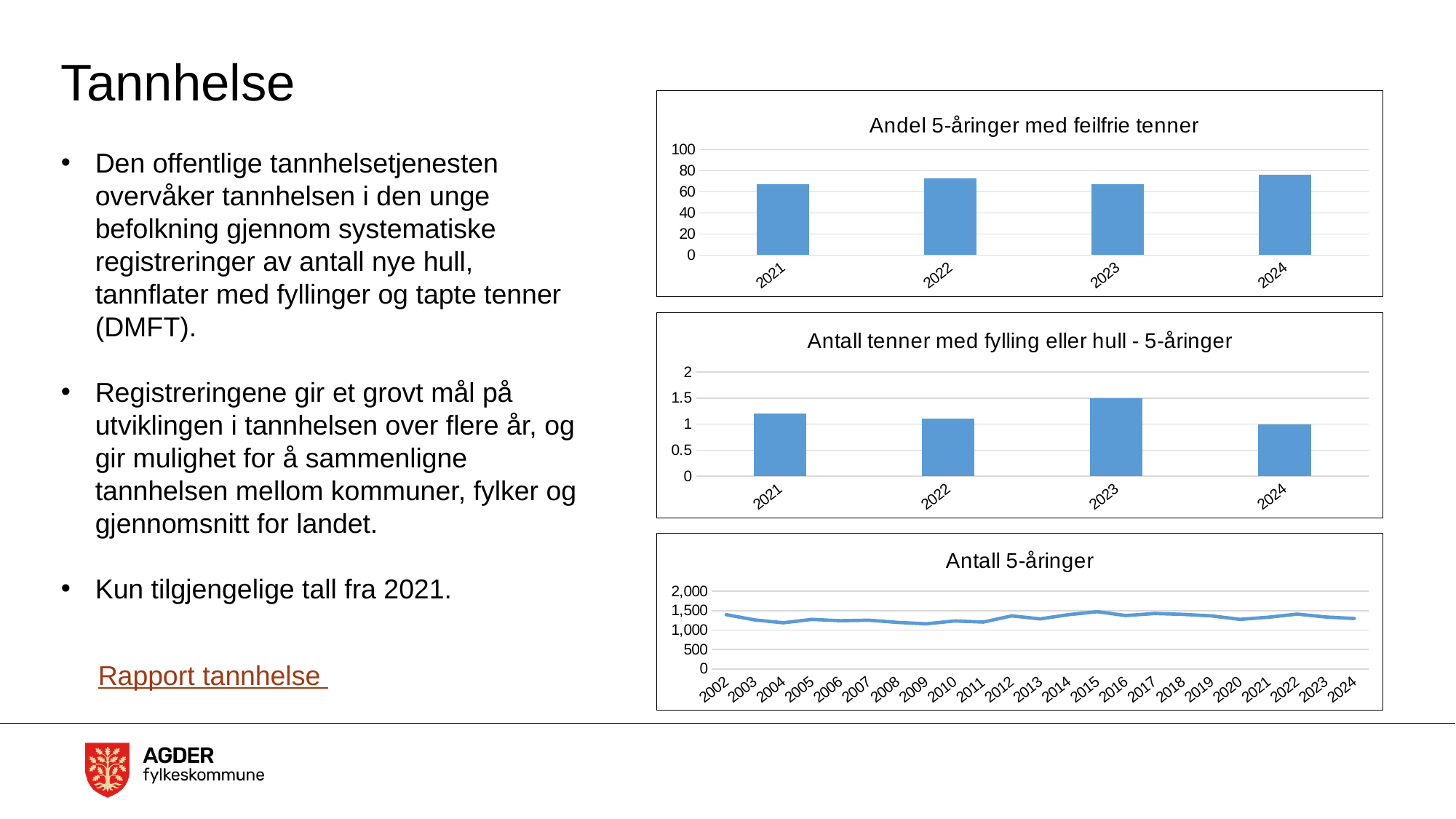
What type of chart is 'Antall 5-åringer'? line chart What type of chart is 'Andel 5-åringer med feilfrie tenner'? bar chart In the chart 'Andel 5-åringer med feilfrie tenner', is the value for 2021 greater or less than 80? less In the chart 'Antall tenner med fylling eller hull - 5-åringer', which year has the lowest value? 2024 How many years are plotted in the chart 'Antall 5-åringer'? 23 In the chart 'Antall tenner med fylling eller hull - 5-åringer', is the value for 2021 greater or less than 1? greater In the chart 'Andel 5-åringer med feilfrie tenner', which year has the highest value? 2024 In the chart 'Antall tenner med fylling eller hull - 5-åringer', what is the value for 2024? 1 In the chart 'Andel 5-åringer med feilfrie tenner', is the value for 2024 greater or less than 60? greater How many years are shown in the chart 'Andel 5-åringer med feilfrie tenner'? 4 In the chart 'Antall tenner med fylling eller hull - 5-åringer', which year has the highest value? 2023